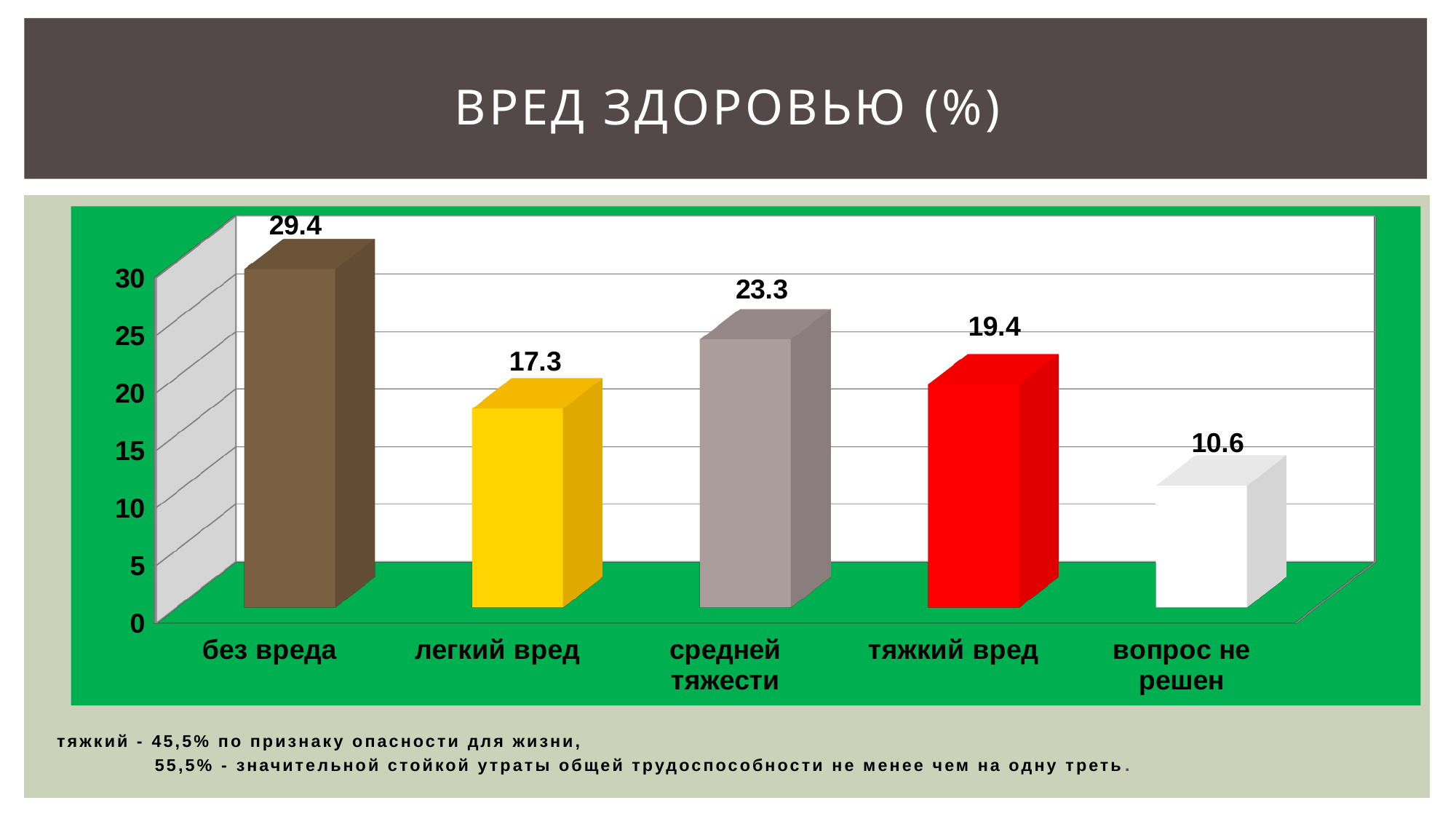
Which category has the highest value? без вреда What is the value for "вопрос не решен"? 10.6 What kind of chart is shown on the slide? bar chart What is the difference between the values for "без вреда" and "вопрос не решен"? 18.8 How many categories are shown in the chart? 5 Which category has the lowest value? вопрос не решен Which is larger, the value for "средней тяжести" or the value for "тяжкий вред"? средней тяжести What is the value for "тяжкий вред"? 19.4 What is the title of the chart? ВРЕД ЗДОРОВЬЮ (%) What is the value for "средней тяжести"? 23.3 What is the value for "без вреда"? 29.4 What is the value for "легкий вред"? 17.3